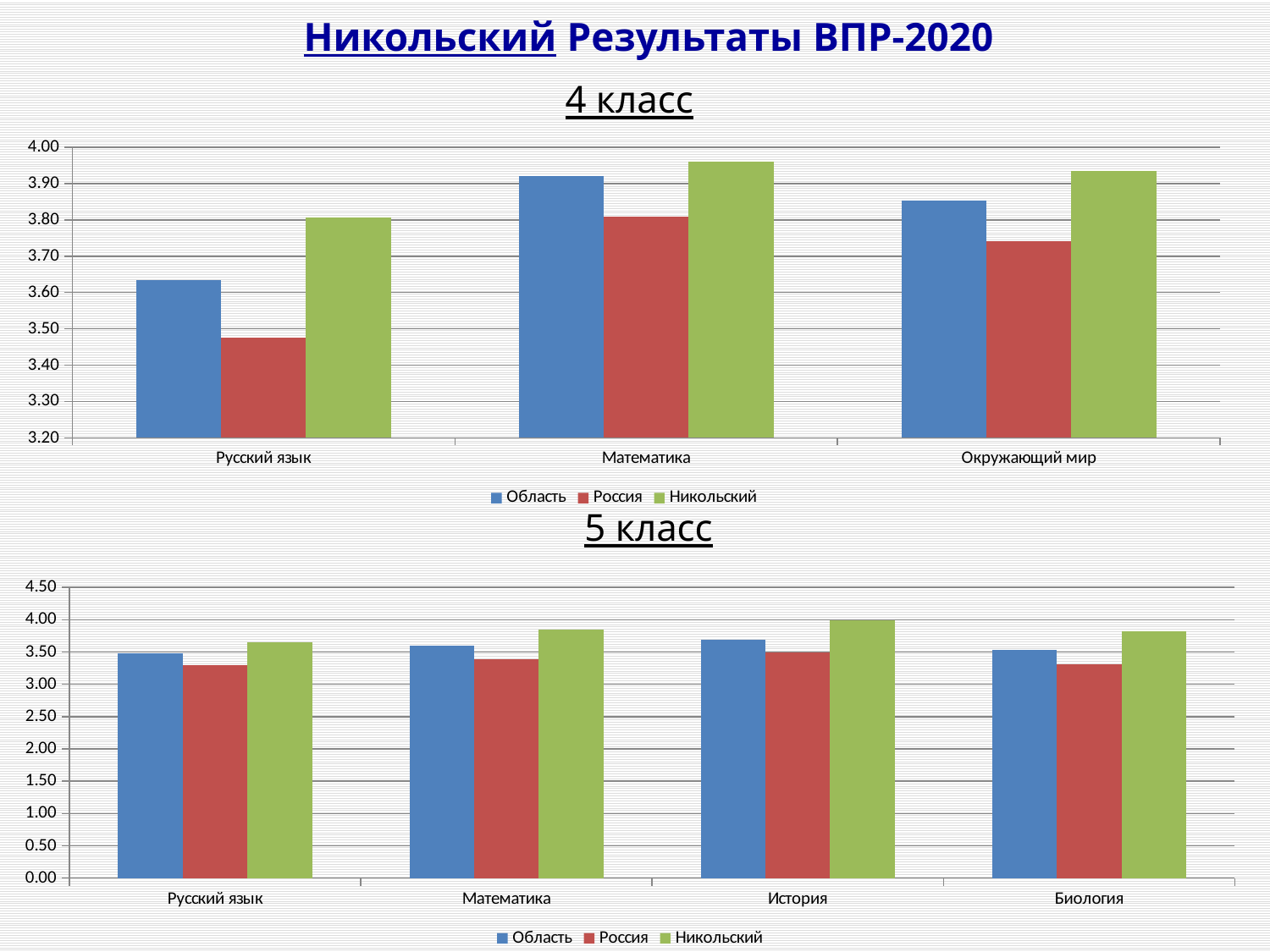
On the "5 класс" chart, is the value for Никольский in История greater or less than 3.50? greater On the "5 класс" chart, is the value for Россия in Русский язык greater or less than 3.50? less On the "5 класс" chart, in which subject is the Никольский value highest? История On the "4 класс" chart, is the value for Область in Русский язык greater or less than 3.70? less What kind of chart is the "4 класс" chart? bar chart How many series does the legend of the "5 класс" chart list? 3 How many subject categories are shown on the "4 класс" chart? 3 On the "4 класс" chart, in which subject is the Россия value lowest? Русский язык On the "5 класс" chart, which is larger for Биология: Область or Никольский? Никольский How many subject categories are shown on the "5 класс" chart? 4